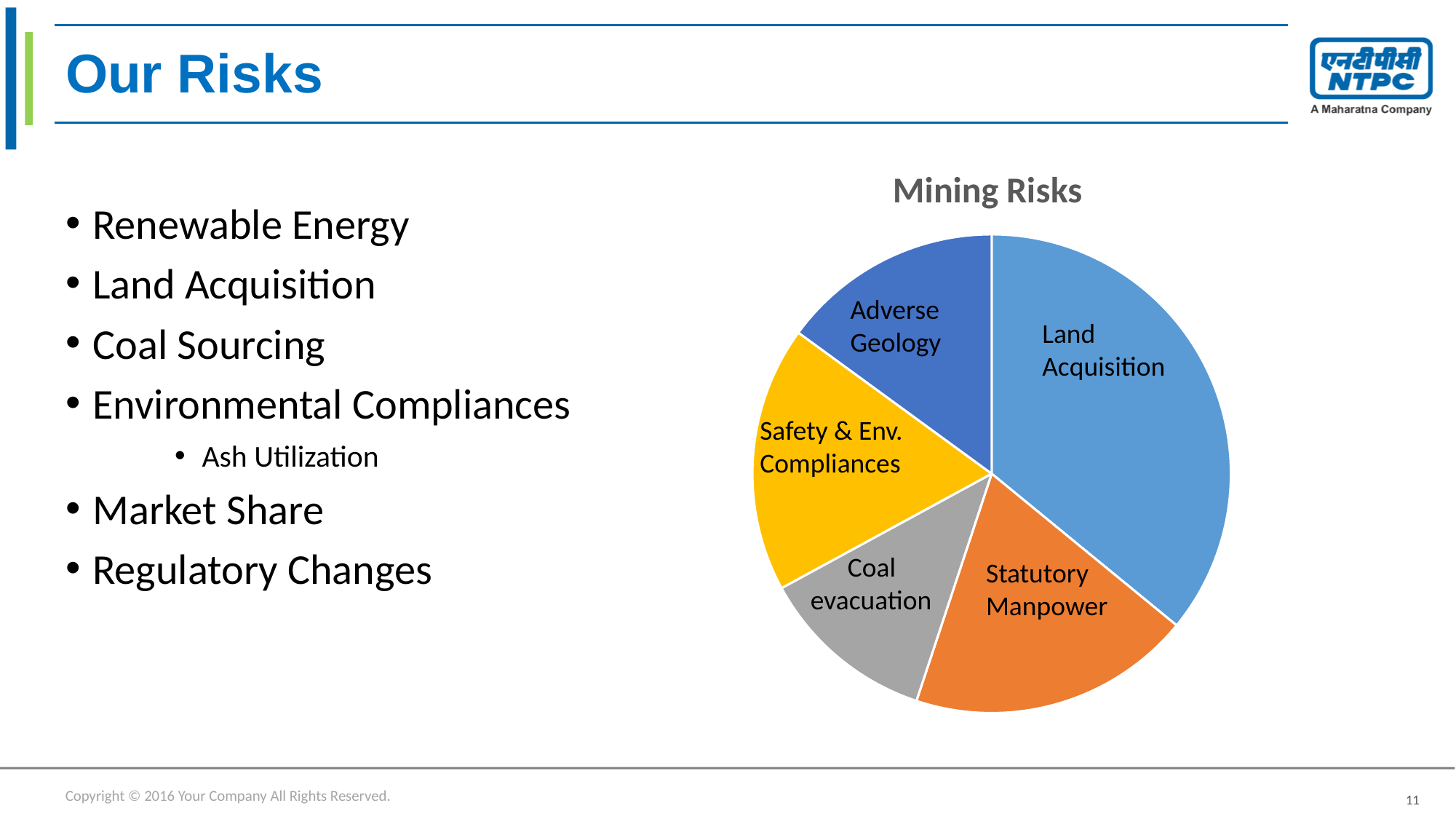
In the Mining Risks pie chart, which is larger: Safety & Env. Compliances or Adverse Geology? Safety & Env. Compliances In the Mining Risks pie chart, which is larger: Coal evacuation or Statutory Manpower? Statutory Manpower How many slices does the Mining Risks pie chart have? 5 What is the title of the chart on the slide? Mining Risks In the Mining Risks pie chart, which is larger: Land Acquisition or Statutory Manpower? Land Acquisition What colour is the Safety & Env. Compliances slice in the Mining Risks pie chart? Yellow Which slice of the Mining Risks pie chart is the largest? Land Acquisition What kind of chart is shown on the slide? Pie chart Which slice of the Mining Risks pie chart is the smallest? Coal evacuation Which slice of the Mining Risks pie chart is coloured grey? Coal evacuation